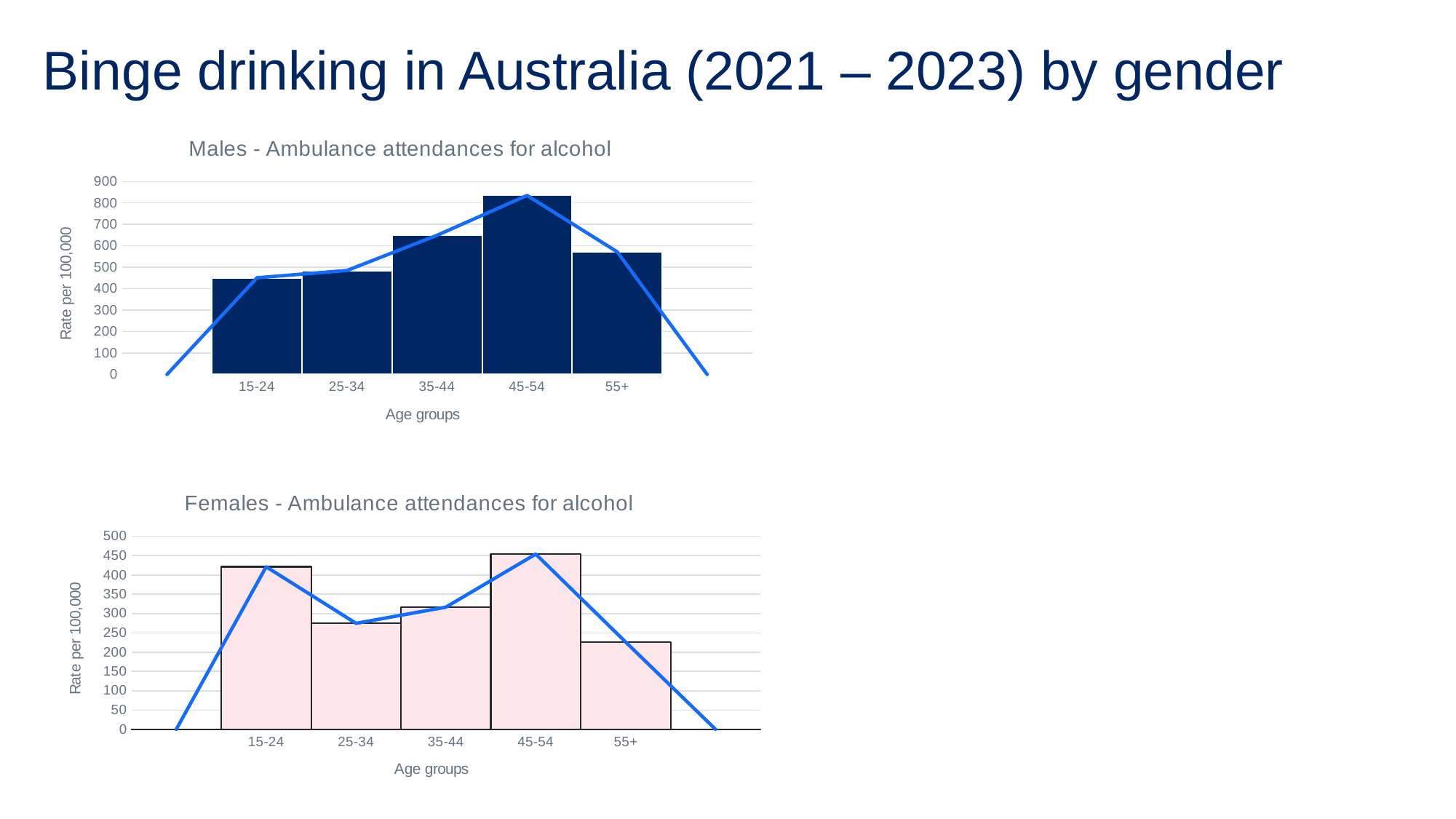
What is the y-axis label of the Females - Ambulance attendances for alcohol chart? Rate per 100,000 In the Females - Ambulance attendances for alcohol chart, which is larger, the value for 15-24 or the value for 35-44? 15-24 In the Females - Ambulance attendances for alcohol chart, is the value for 15-24 greater or less than 400? greater In the Males - Ambulance attendances for alcohol chart, which age group has the highest rate? 45-54 In the Males - Ambulance attendances for alcohol chart, is the value for 25-34 greater or less than 500? less In the Females - Ambulance attendances for alcohol chart, is the value for 25-34 greater or less than 300? less In the Males - Ambulance attendances for alcohol chart, which is larger, the value for 35-44 or the value for 55+? 35-44 In the Males - Ambulance attendances for alcohol chart, which age group has the lowest rate? 15-24 How many age groups are shown in the Males - Ambulance attendances for alcohol chart? 5 In the Females - Ambulance attendances for alcohol chart, which age group has the lowest rate? 55+ In the Females - Ambulance attendances for alcohol chart, which age group has the highest rate? 45-54